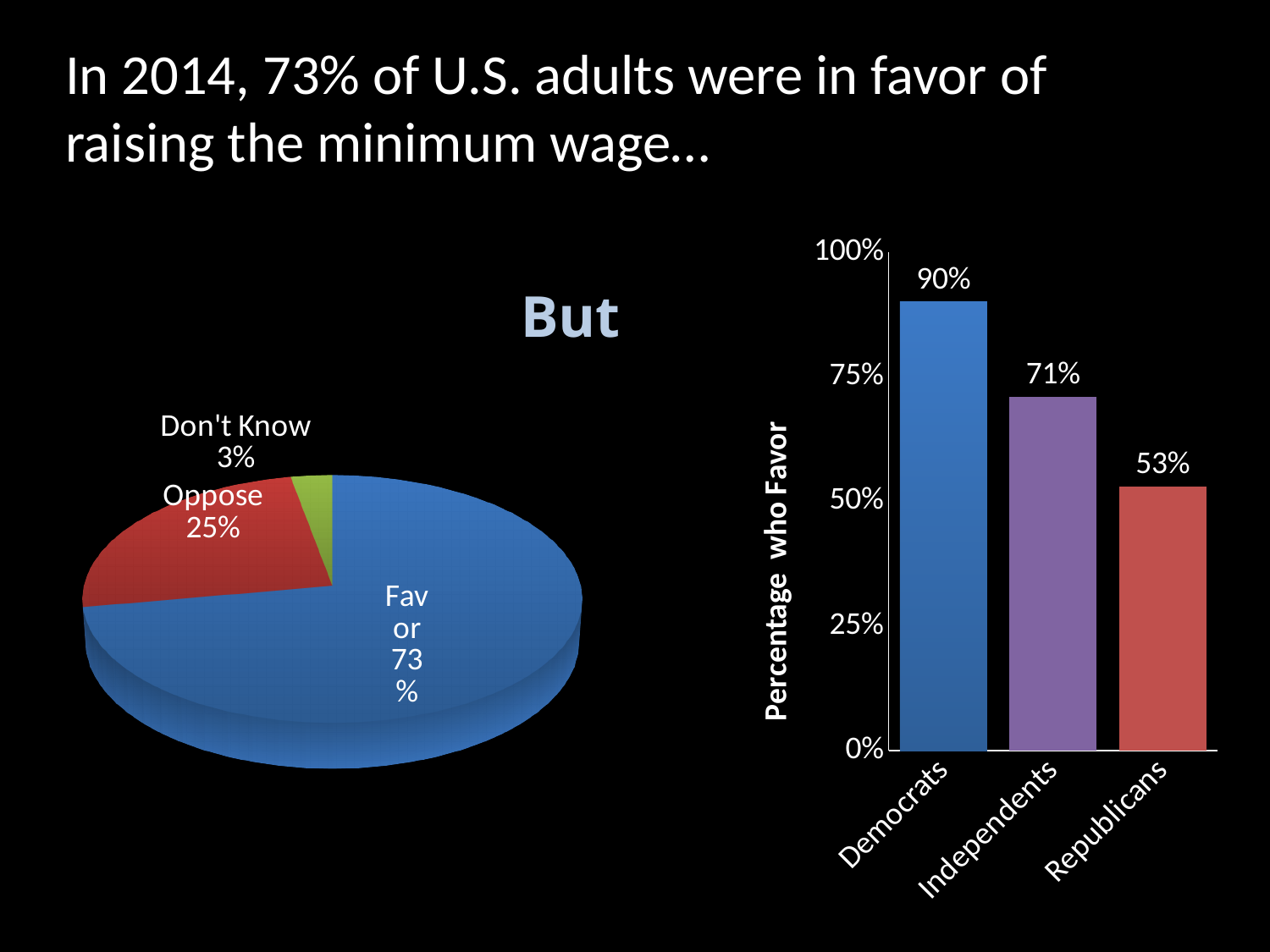
In the pie chart on the left, what percentage opposed raising the minimum wage? 25% What kind of chart is on the right side of the slide? Bar chart In the bar chart on the right, what is the difference between the Democrats and Republicans values? 37% In the bar chart on the right, what percentage of Democrats favor raising the minimum wage? 90% In the pie chart on the left, what percentage of U.S. adults were in favor of raising the minimum wage? 73% In the pie chart on the left, what share is labeled Don't Know? 3% In the pie chart on the left, how many slices are there? 3 In the bar chart on the right, which is larger, the value for Independents or the value for Republicans? Independents In the bar chart on the right, what is the label of the vertical axis? Percentage who Favor In the pie chart on the left, which slice is the smallest? Don't Know In the bar chart on the right, what is the value for Independents? 71% In the bar chart on the right, which group has the lowest percentage who favor? Republicans